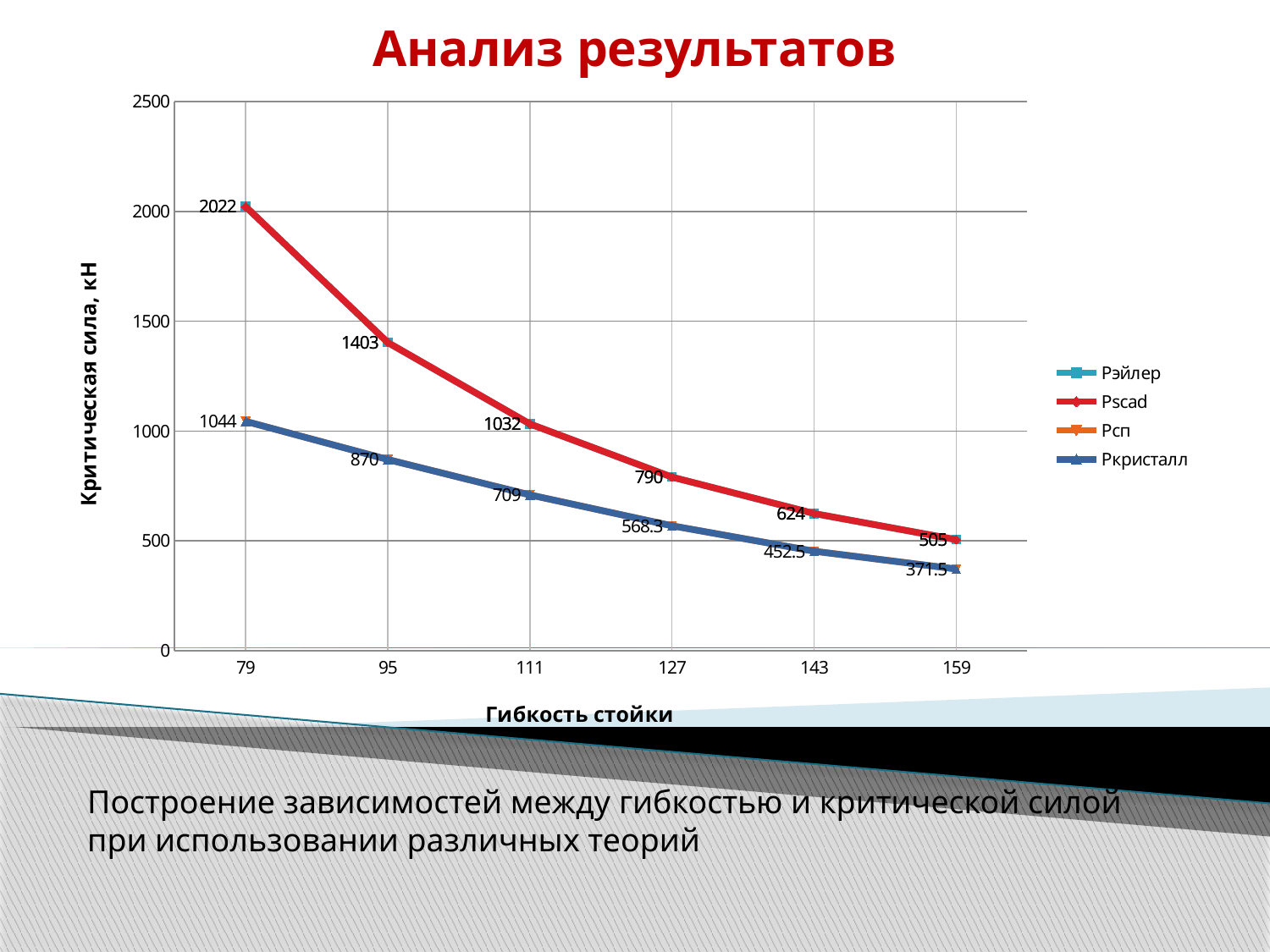
What kind of chart is shown on the slide? line chart How many x-axis categories (values of Гибкость стойки) are plotted? 6 What is the title of the y axis? Критическая сила, кН What is the difference between the upper (red) line and the lower (blue) line at Гибкость стойки = 79? 978 What is the difference between the upper (red) line values at Гибкость стойки = 95 and 143? 779 What is the value of the lower (blue) line at Гибкость стойки = 127? 568.3 What is the value of the lower (blue) line at Гибкость стойки = 159? 371.5 Do the values of the lines rise or fall as Гибкость стойки increases? fall How many series does the legend list? 4 What is the value of the upper (red) line at Гибкость стойки = 111? 1032 Which is larger at Гибкость стойки = 143: the upper (red) line value or the lower (blue) line value? the upper (red) line, 624 What is the value of the upper (red) line at Гибкость стойки = 79? 2022